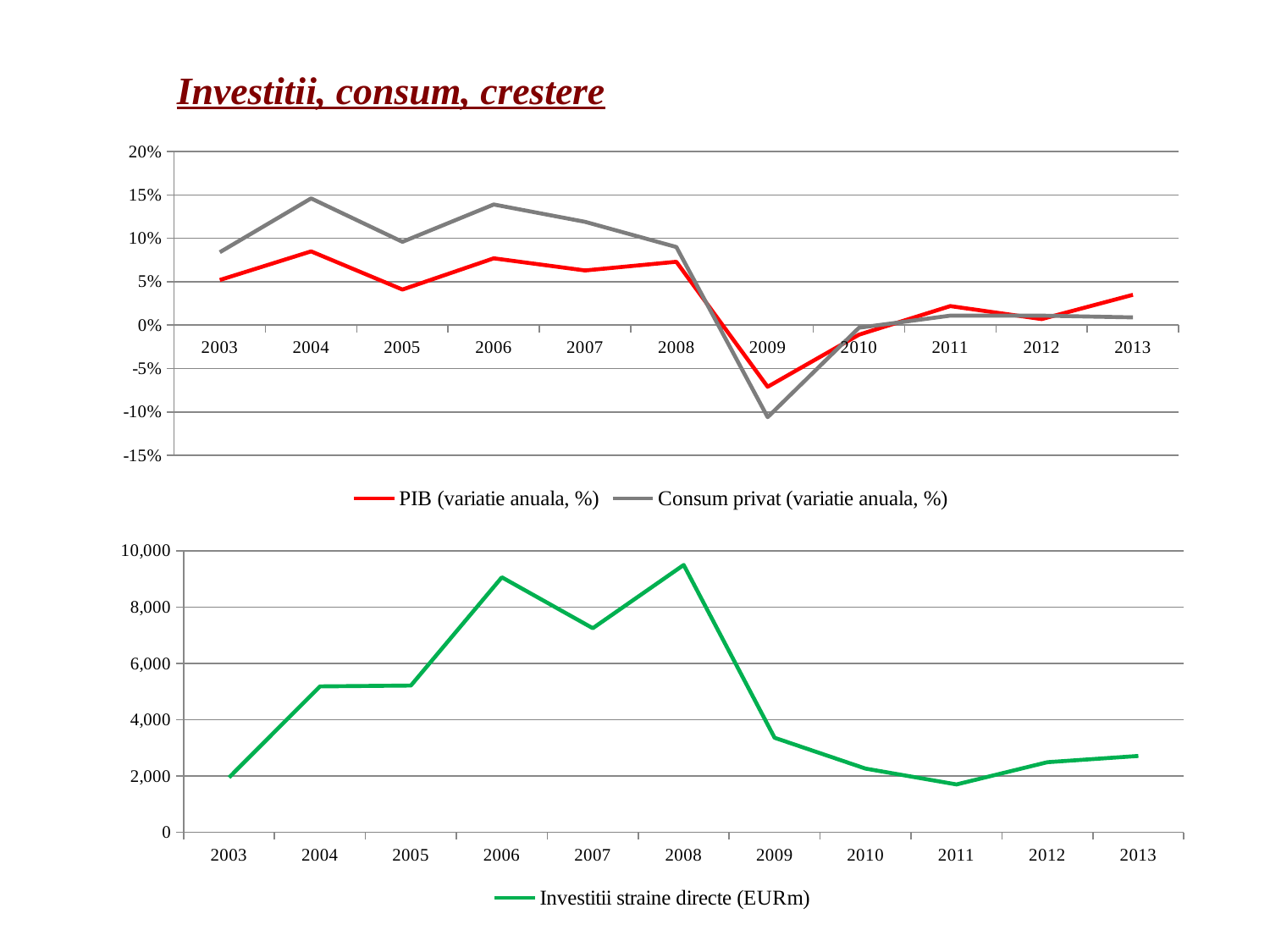
How many series does the legend of the top chart list? 2 In the top chart, is the value for PIB in 2009 greater or less than -5%? less What kind of chart is the top chart on the slide? line chart In the bottom chart, is the value for 2009 greater or less than 4,000? less In the top chart, in which year is Consum privat (variatie anuala, %) lowest? 2009 How many years are plotted on the x axis of the bottom chart (Investitii straine directe)? 11 In the bottom chart, in which year is Investitii straine directe (EURm) highest? 2008 In the top chart, in which year is PIB (variatie anuala, %) lowest? 2009 In the bottom chart, which year has the larger value: 2006 or 2007? 2006 In the top chart, is the value for Consum privat in 2004 greater or less than 10%? greater In the top chart, which is larger in 2008: PIB or Consum privat? Consum privat What is the title of the slide? Investitii, consum, crestere